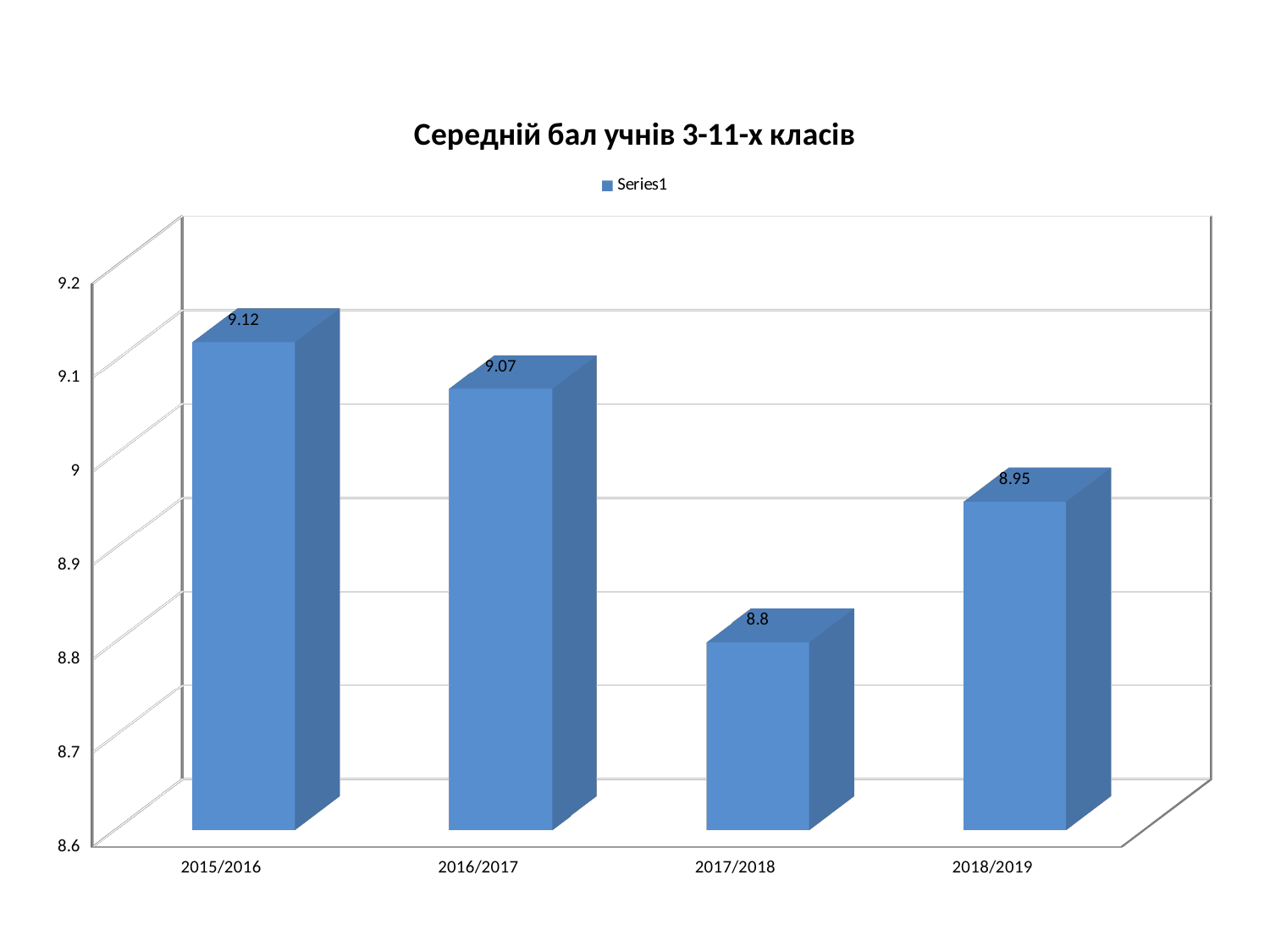
What is the value for 2017/2018? 8.8 What is the value for 2015/2016? 9.12 How many school years are shown on the chart? 4 What is the title of the chart? Середній бал учнів 3-11-х класів Is the value for 2016/2017 greater or less than 9? greater What is the difference between the values for 2018/2019 and 2017/2018? 0.15 What kind of chart is shown on the slide? bar chart Which school year has the highest average score? 2015/2016 What is the value for 2018/2019? 8.95 What is the difference between the values for 2015/2016 and 2017/2018? 0.32 Which is larger, the value for 2016/2017 or the value for 2018/2019? 2016/2017 Which school year has the lowest average score? 2017/2018